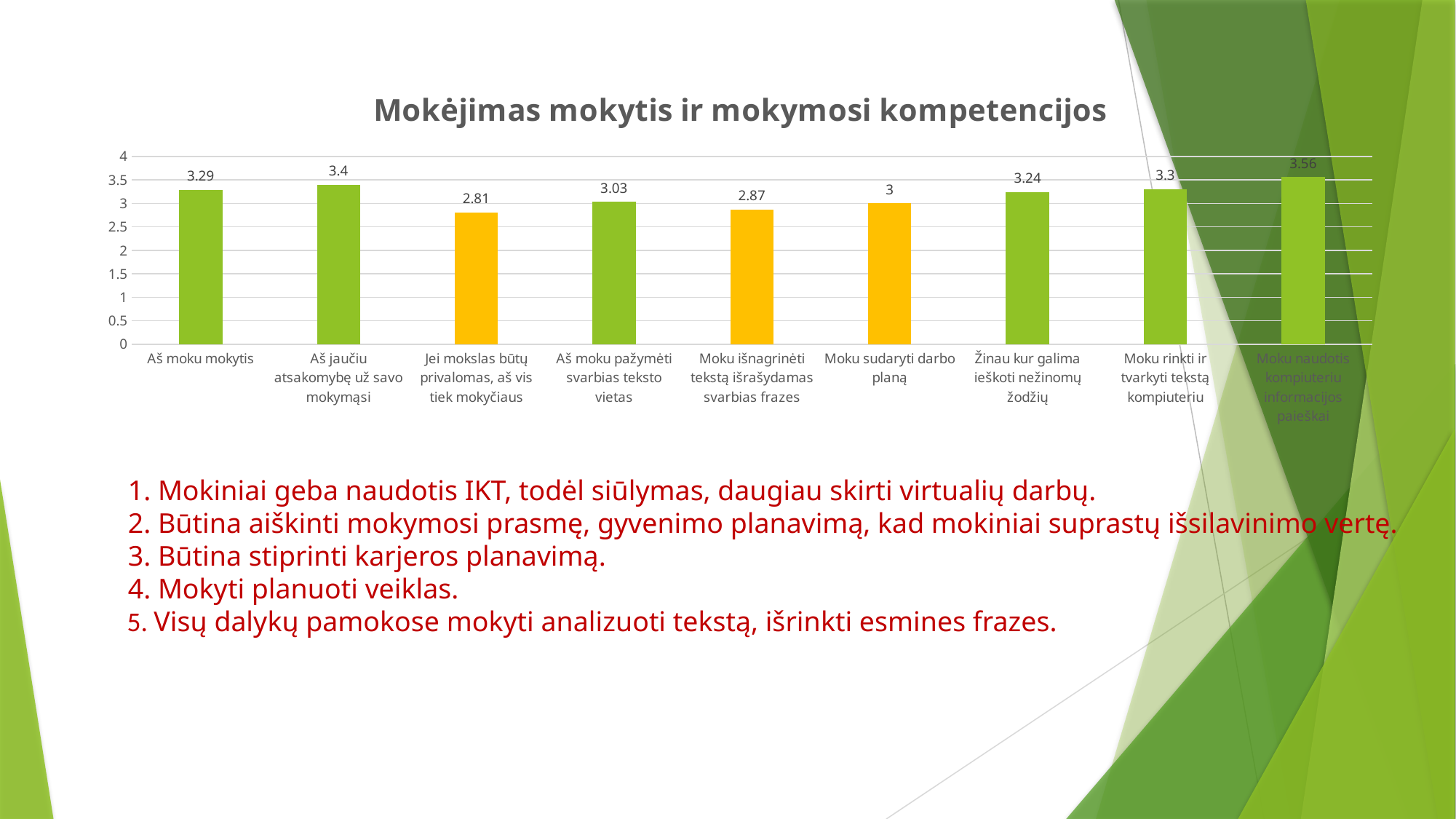
What is the difference between the values for "Aš jaučiu atsakomybę už savo mokymąsi" and "Moku išnagrinėti tekstą išrašydamas svarbias frazes"? 0.53 Which category has the highest value? Moku naudotis kompiuteriu informacijos paieškai What is the value for "Moku sudaryti darbo planą"? 3 What is the title of the chart? Mokėjimas mokytis ir mokymosi kompetencijos What is the value for "Jei mokslas būtų privalomas, aš vis tiek mokyčiaus"? 2.81 What kind of chart is shown on the slide? bar chart What is the value for "Aš moku mokytis"? 3.29 Is the value for "Moku išnagrinėti tekstą išrašydamas svarbias frazes" greater or less than 3? less How many categories are shown in the chart? 9 Which is larger: the value for "Aš moku pažymėti svarbias teksto vietas" or the value for "Moku rinkti ir tvarkyti tekstą kompiuteriu"? Moku rinkti ir tvarkyti tekstą kompiuteriu Which category has the lowest value? Jei mokslas būtų privalomas, aš vis tiek mokyčiaus What is the value for "Žinau kur galima ieškoti nežinomų žodžių"? 3.24